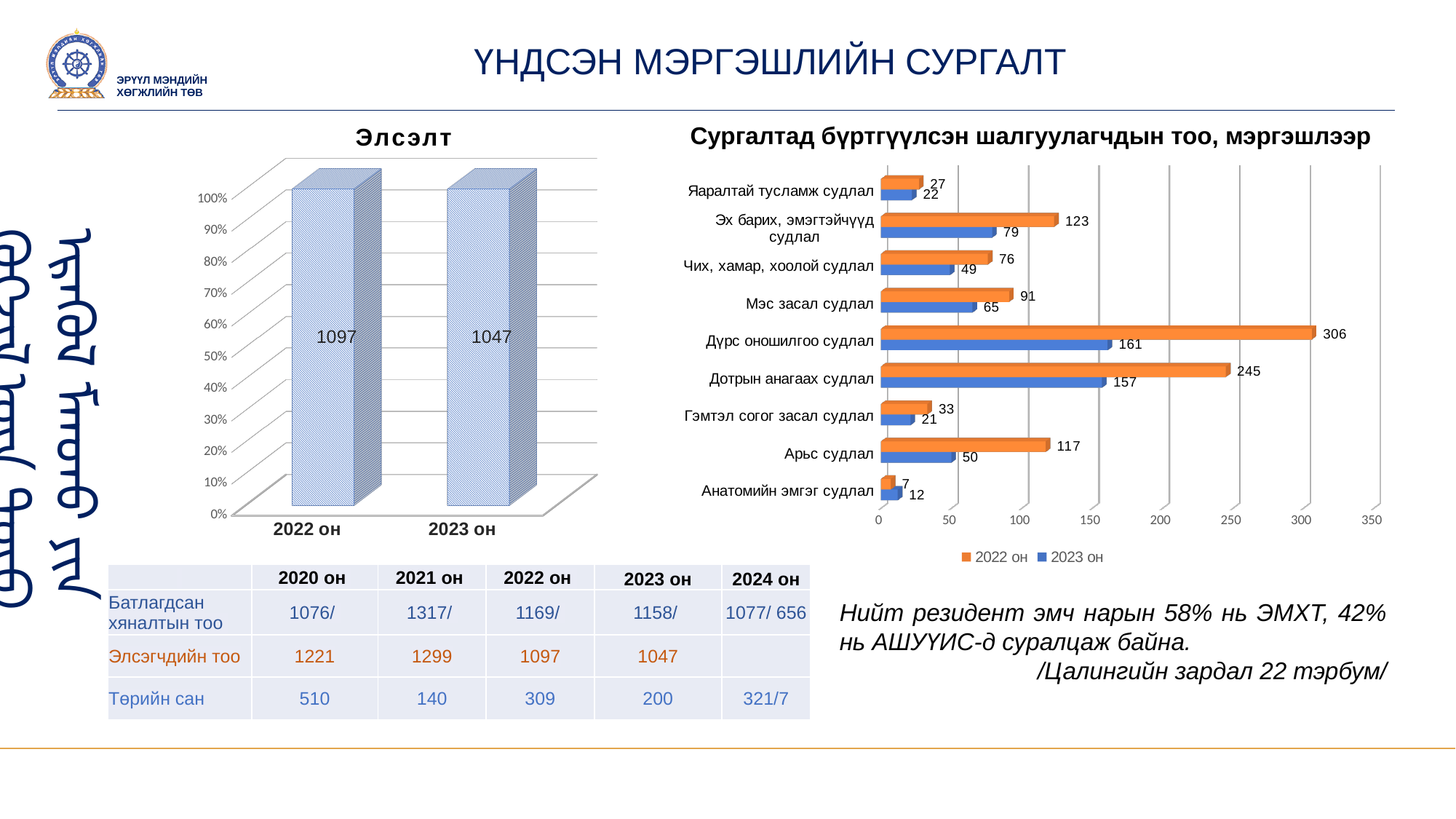
In the 'Сургалтад бүртгүүлсэн шалгуулагчдын тоо, мэргэшлээр' chart, which category has the highest 2022 он value? Дүрс оношилгоо судлал In the 'Элсэлт' chart, how many categories are shown on the x axis? 2 In the 'Сургалтад бүртгүүлсэн шалгуулагчдын тоо, мэргэшлээр' chart, what is the 2023 он value for Дотрын анагаах судлал? 157 In the 'Сургалтад бүртгүүлсэн шалгуулагчдын тоо, мэргэшлээр' chart, what is the difference between the 2022 он and 2023 он values for Эх барих, эмэгтэйчүүд судлал? 44 In the 'Элсэлт' chart, what is the difference between the 2022 он and 2023 он values? 50 In the 'Сургалтад бүртгүүлсэн шалгуулагчдын тоо, мэргэшлээр' chart, what is the 2022 он value for Дүрс оношилгоо судлал? 306 In the 'Элсэлт' chart, what is the value for 2023 он? 1047 In the 'Элсэлт' chart, what is the value for 2022 он? 1097 What kind of chart is the 'Сургалтад бүртгүүлсэн шалгуулагчдын тоо, мэргэшлээр' chart? Bar chart In the 'Сургалтад бүртгүүлсэн шалгуулагчдын тоо, мэргэшлээр' chart, how many series does the legend list? 2 In the 'Сургалтад бүртгүүлсэн шалгуулагчдын тоо, мэргэшлээр' chart, which category has the lowest 2022 он value? Анатомийн эмгэг судлал In the 'Сургалтад бүртгүүлсэн шалгуулагчдын тоо, мэргэшлээр' chart, which is larger for Анатомийн эмгэг судлал: the 2022 он value or the 2023 он value? 2023 он